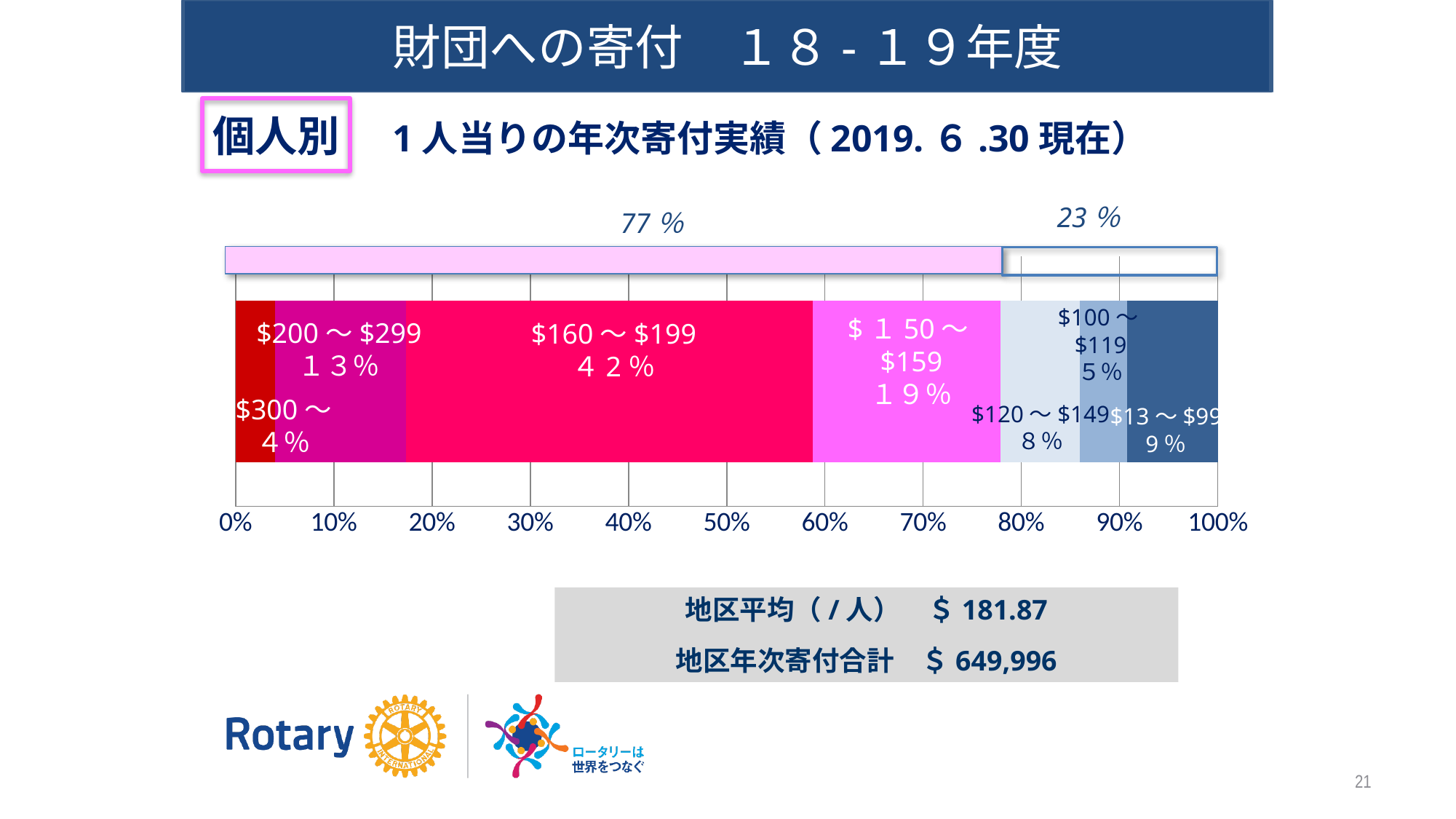
Which giving range has the smallest share of members? $300〜 Which share is larger: $200〜$299 or $120〜$149? $200〜$299 What percentage of members gave in the $100〜$119 range? 5% What is the district average per person (地区平均) shown below the chart? $181.87 How many giving-range segments are shown in the stacked bar? 7 What percentage of members gave $300 or more ($300〜)? 4% What combined share is shown above the bar for the segments from $150 upward? 77% What percentage of members gave in the $160〜$199 range? 42% What percentage of members gave in the $13〜$99 range? 9% What kind of chart is shown on the slide? Stacked bar chart Which giving range has the largest share of members? $160〜$199 How many percentage points larger is the $160〜$199 share than the $150〜$159 share? 23 percentage points